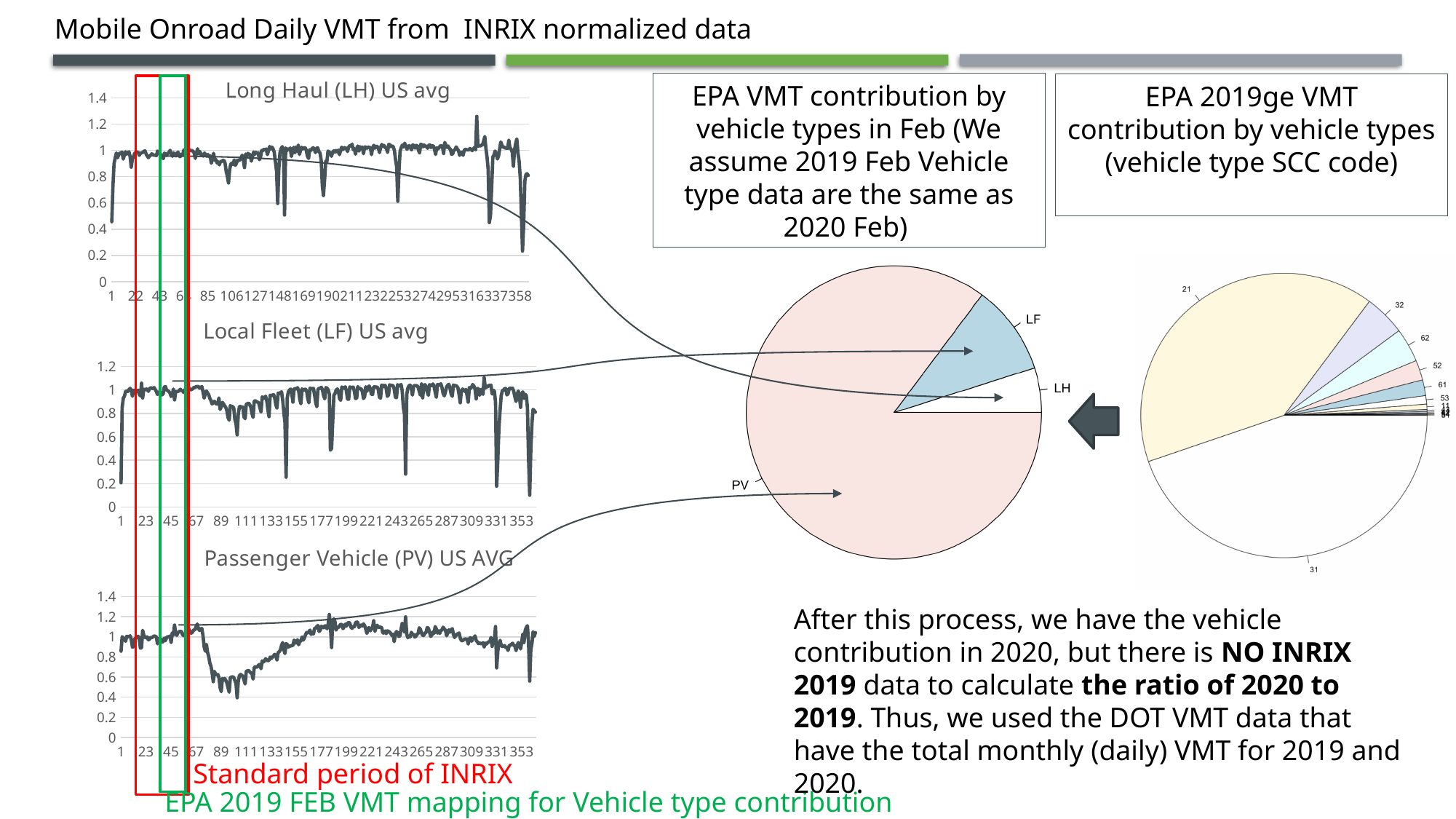
In the "Long Haul (LH) US avg" chart, is the highest value greater or less than 1.4? less In the "Passenger Vehicle (PV) US AVG" chart, is the lowest value greater or less than 0.8? less In the "EPA VMT contribution by vehicle types in Feb" pie chart, which slice is larger, LF or LH? LF How many line charts are shown on the left side of the slide? 3 What is the title of the middle line chart on the left of the slide? Local Fleet (LF) US avg What kind of chart is the "Long Haul (LH) US avg" chart? line chart In the "EPA VMT contribution by vehicle types in Feb" pie chart, which vehicle type has the smallest slice? LH In the "EPA VMT contribution by vehicle types in Feb" pie chart, which vehicle type has the largest slice? PV What is the title of the bottom line chart on the left of the slide? Passenger Vehicle (PV) US AVG In the "EPA VMT contribution by vehicle types in Feb" pie chart, how many slices are there? 3 What kind of chart is the "EPA VMT contribution by vehicle types in Feb" chart? pie chart In the "EPA 2019 VMT contribution by vehicle types" pie chart, which slice is larger, 21 or 32? 21